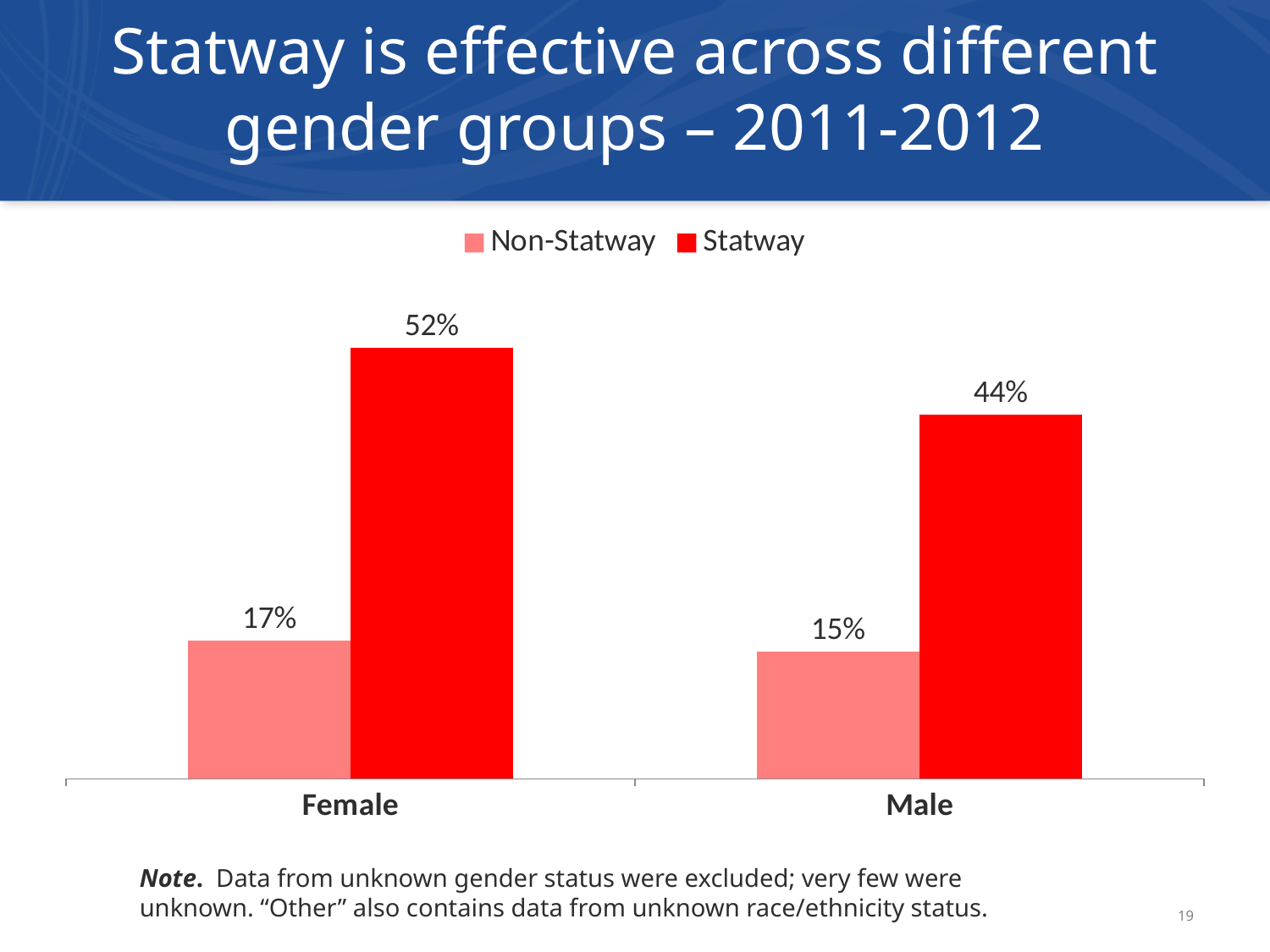
What is the Statway value for Male? 44% What is the difference between the Statway values for Female and Male? 8% What is the Statway value for Female? 52% How many gender groups are shown on the x axis? 2 What is the difference between the Statway and Non-Statway values for Female? 35% How many series does the legend list? 2 What is the Non-Statway value for Female? 17% Which gender group has the highest Statway value? Female What kind of chart is shown on the slide? Bar chart Which bar on the chart has the lowest value? Non-Statway for Male Which is larger, the Non-Statway value for Female or the Non-Statway value for Male? Non-Statway value for Female What is the Non-Statway value for Male? 15%